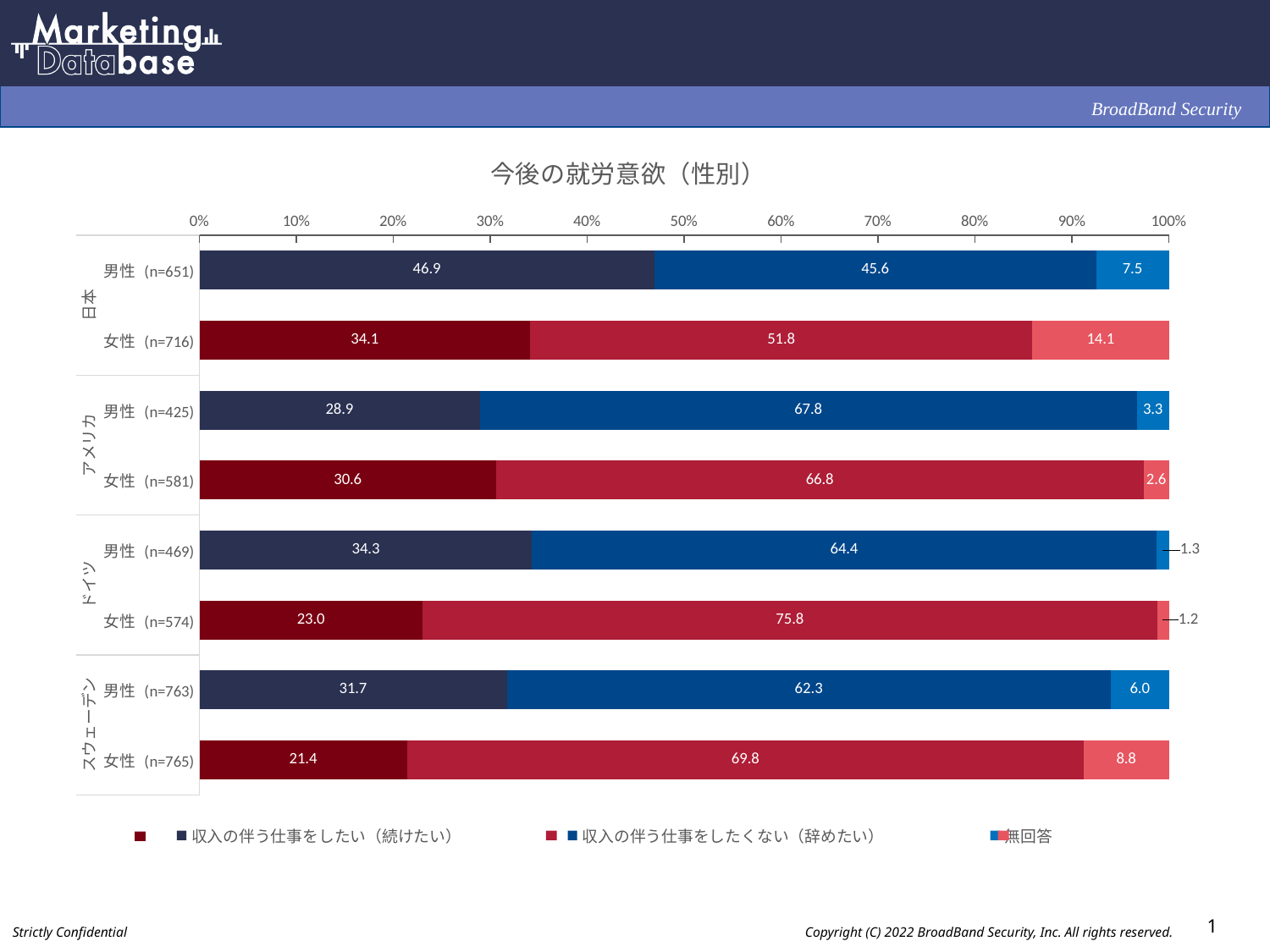
How many groups (bars) are plotted in the chart? 8 What is the value of 収入の伴う仕事をしたい（続けたい） for 日本 男性 (n=651)? 46.9 What is the title of the chart? 今後の就労意欲（性別） How many series does the legend list? 3 Which is larger: the 無回答 value for スウェーデン 男性 (n=763) or for スウェーデン 女性 (n=765)? スウェーデン 女性 (n=765) Which group has the highest value for 収入の伴う仕事をしたくない（辞めたい）? ドイツ 女性 (n=574) What is the value of 収入の伴う仕事をしたい（続けたい） for スウェーデン 女性 (n=765)? 21.4 What type of chart is shown on the slide? stacked bar chart What is the difference between the 収入の伴う仕事をしたい（続けたい） values for 日本 男性 (n=651) and 日本 女性 (n=716)? 12.8 Which group has the lowest value for 無回答? ドイツ 女性 (n=574) What is the value of 収入の伴う仕事をしたくない（辞めたい） for アメリカ 男性 (n=425)? 67.8 What is the value of 無回答 for 日本 女性 (n=716)? 14.1